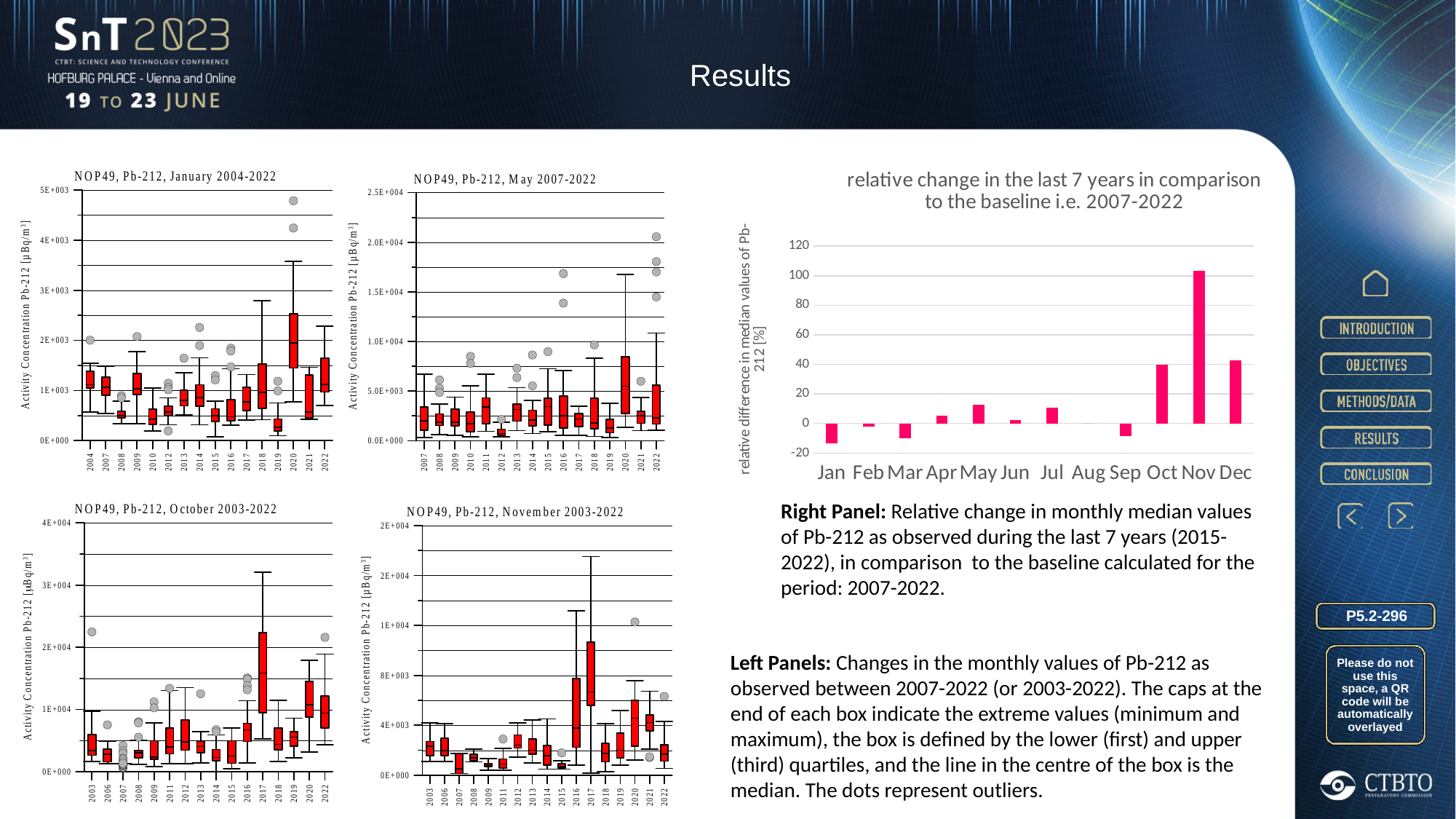
How many years are shown on the x axis of the chart 'NOP49, Pb-212, May 2007-2022'? 16 In the chart 'relative change in the last 7 years in comparison to the baseline i.e. 2007-2022', which is larger, the value for Dec or the value for Jul? Dec How many years are shown on the x axis of the chart 'NOP49, Pb-212, November 2003-2022'? 17 In the chart 'relative change in the last 7 years in comparison to the baseline i.e. 2007-2022', which month has the highest value? Nov In the chart 'relative change in the last 7 years in comparison to the baseline i.e. 2007-2022', is the value for Oct greater or less than 20? greater In the chart 'relative change in the last 7 years in comparison to the baseline i.e. 2007-2022', how many months are shown on the x axis? 12 In the chart 'relative change in the last 7 years in comparison to the baseline i.e. 2007-2022', is the value for Jan greater or less than 0? less In the chart 'relative change in the last 7 years in comparison to the baseline i.e. 2007-2022', is the value for Nov greater or less than 80? greater In the chart 'NOP49, Pb-212, January 2004-2022', which year has the highest median? 2020 What is the y-axis label of the chart 'relative change in the last 7 years in comparison to the baseline i.e. 2007-2022'? relative difference in median values of Pb-212 [%] What type of chart is the chart titled 'relative change in the last 7 years in comparison to the baseline i.e. 2007-2022'? bar chart In the chart 'NOP49, Pb-212, October 2003-2022', which year has the highest median? 2017